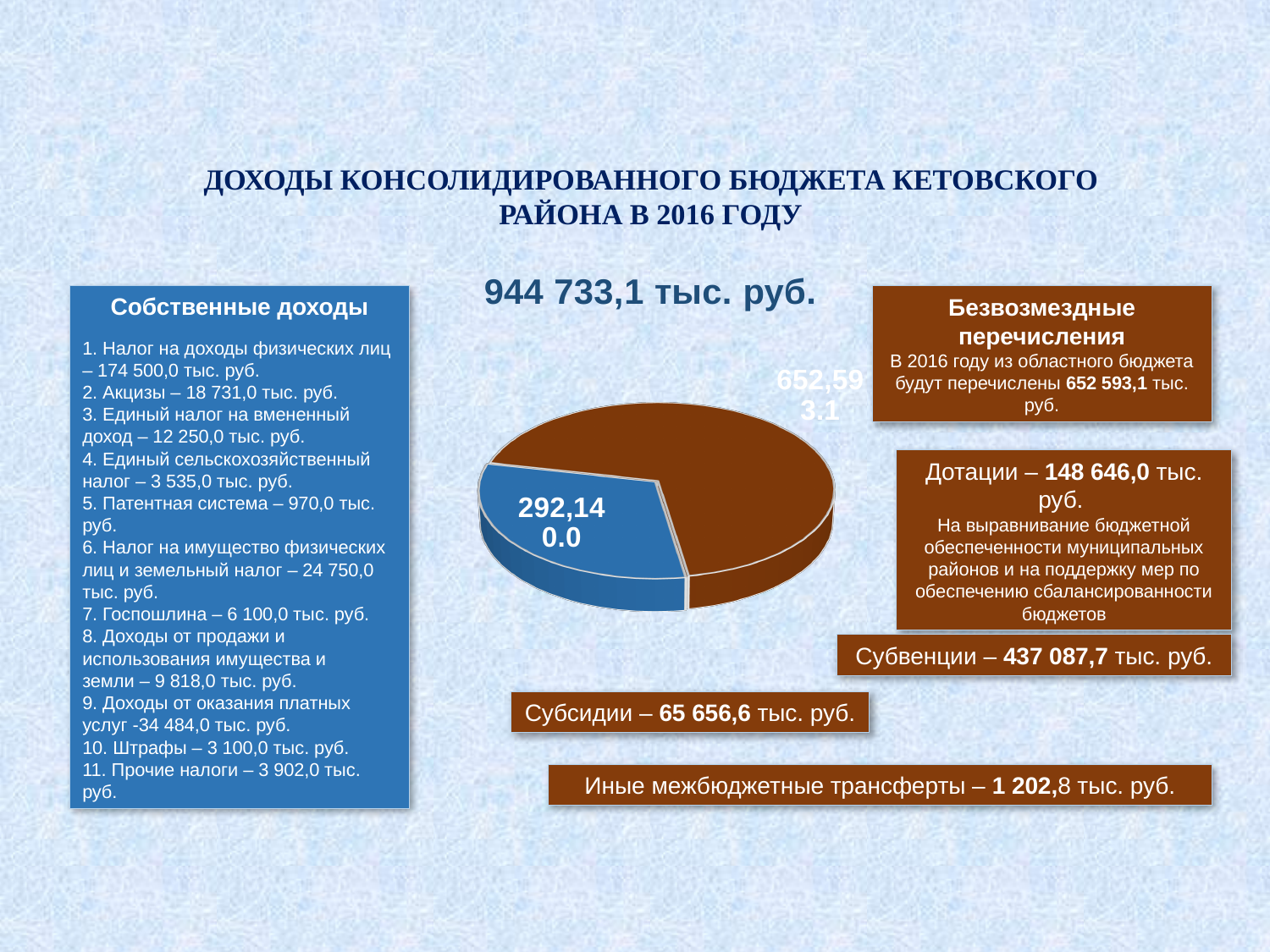
What is the difference between the brown slice value and the blue slice value in the pie chart? 360,453.1 Which slice of the pie chart is the smallest? the blue slice (292,140.0) What share of the total 944 733,1 тыс. руб. does the brown slice (652,593.1) represent? 69.1% What colour is the smaller slice of the pie chart? blue What share of the total 944 733,1 тыс. руб. does the blue slice (292,140.0) represent? 30.9% Which is larger in the pie chart: the blue slice or the brown slice? the brown slice What kind of chart is shown on the slide? pie chart Which slice of the pie chart is the largest? the brown slice (652,593.1) What total amount is printed above the pie chart? 944 733,1 тыс. руб. How many slices does the pie chart have? 2 What value is printed on the blue slice of the pie chart? 292,140.0 What value is printed on the brown slice of the pie chart? 652,593.1